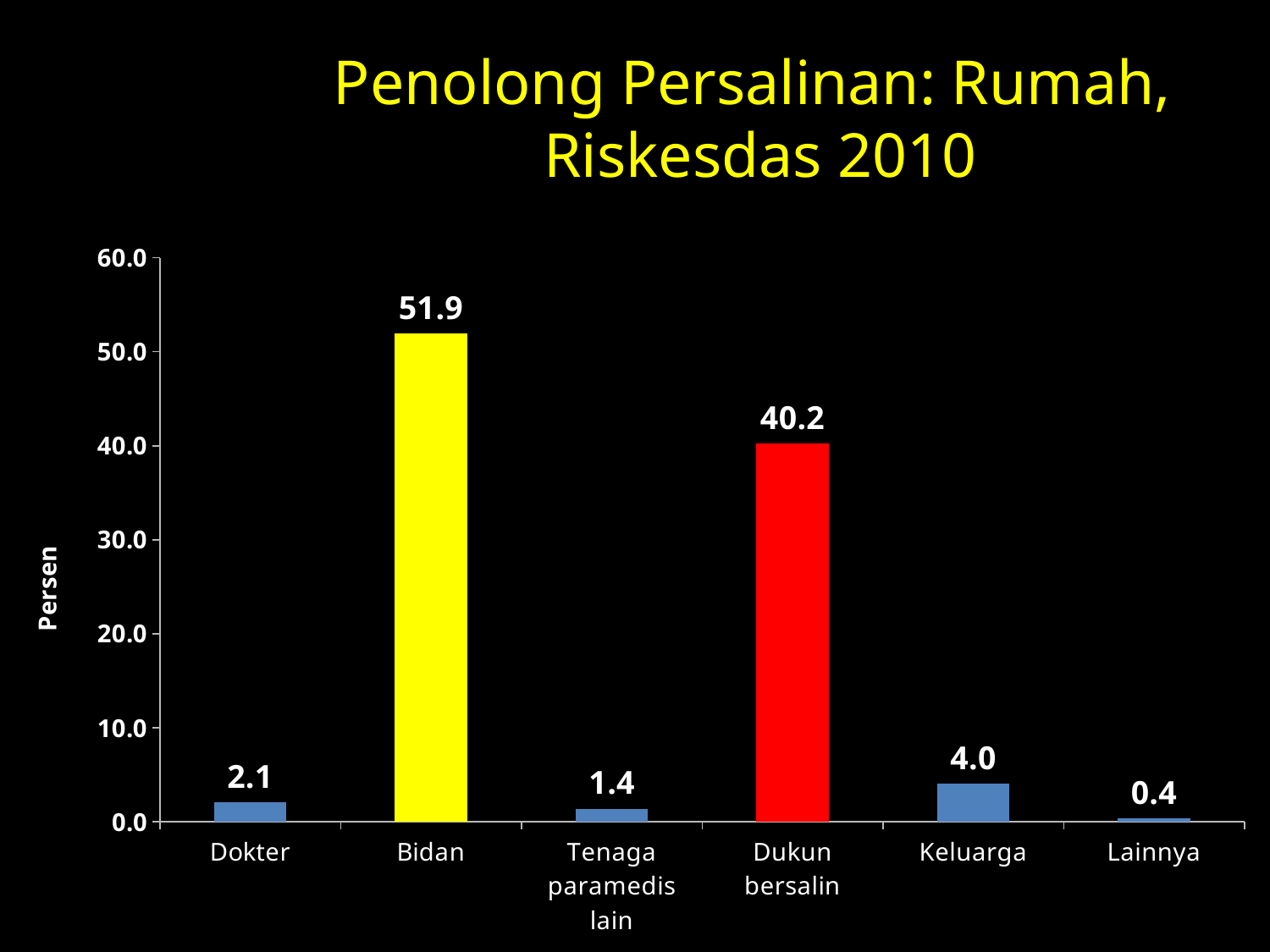
What is the value for Tenaga paramedis lain? 1.4 What is the value for Bidan? 51.9 Which category has the highest value? Bidan What is the label of the vertical axis? Persen Is the value for Dukun bersalin greater or less than 30.0? greater What is the value for Keluarga? 4.0 What is the value for Dukun bersalin? 40.2 How many categories are shown on the x axis? 6 What kind of chart is shown on the slide? bar chart Which category has the lowest value? Lainnya Which is larger, the value for Dokter or the value for Keluarga? Keluarga What is the difference between the values for Bidan and Dukun bersalin? 11.7